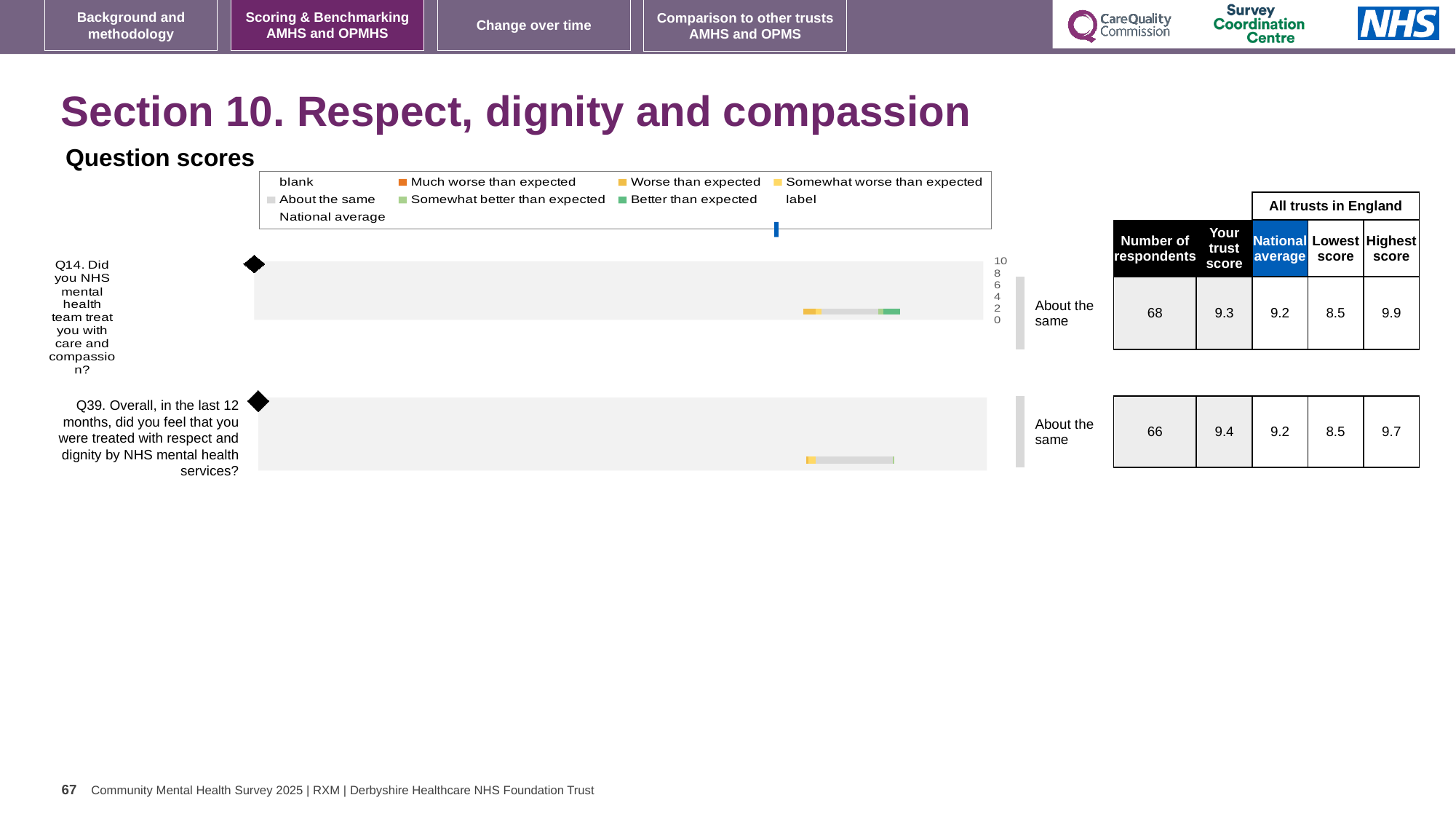
What is the trust score for Q39 (respect and dignity)? 9.4 What kind of chart is shown under 'Question scores'? bar chart How is the trust's result for Q39 categorised relative to other trusts? About the same By how much does the trust score for Q39 exceed the national average? 0.2 Which question has the higher trust score, Q14 or Q39? Q39 What is the difference between the highest and lowest scores for Q14? 1.4 What is the trust score for Q14 (care and compassion)? 9.3 What colour does the legend use for 'Better than expected'? green What is the national average score for Q39? 9.2 What is the highest score among all trusts in England for Q14? 9.9 How many questions (categories) are plotted in the Question scores chart? 2 How many respondents answered Q14? 68